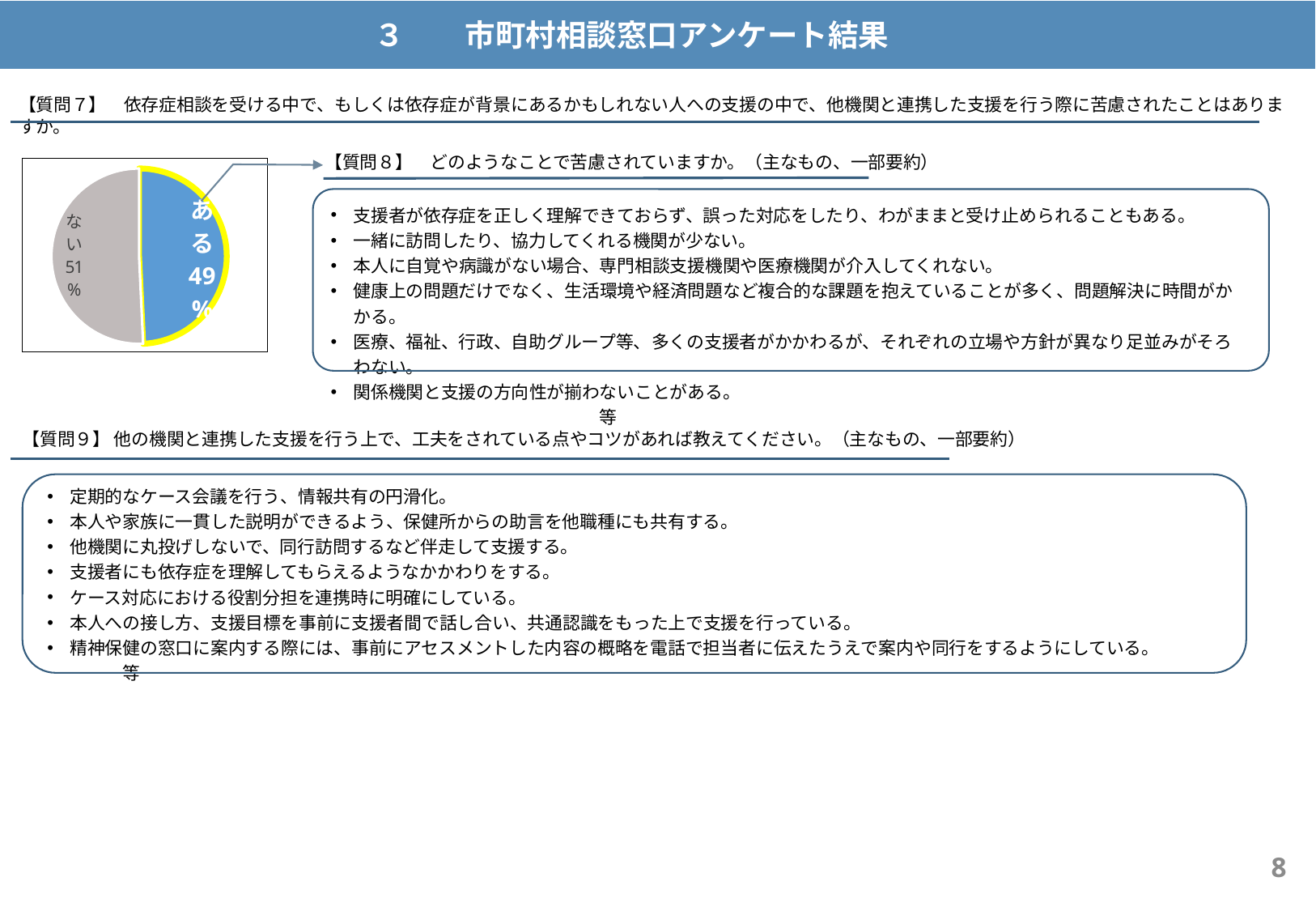
What is the difference in percentage points between the ない slice and the ある slice? 2% What share of the pie does the ある slice represent? 49% What kind of chart is shown on the slide? pie chart What colour is the ある slice of the pie chart? blue How many slices does the pie chart have? 2 What colour is the ない slice of the pie chart? gray What percentage is shown for the ある slice of the pie chart? 49% Which slice of the pie chart is the smallest? ある Which slice of the pie chart is the largest? ない Which is larger in the pie chart, ある or ない? ない What percentage is shown for the ない slice of the pie chart? 51%